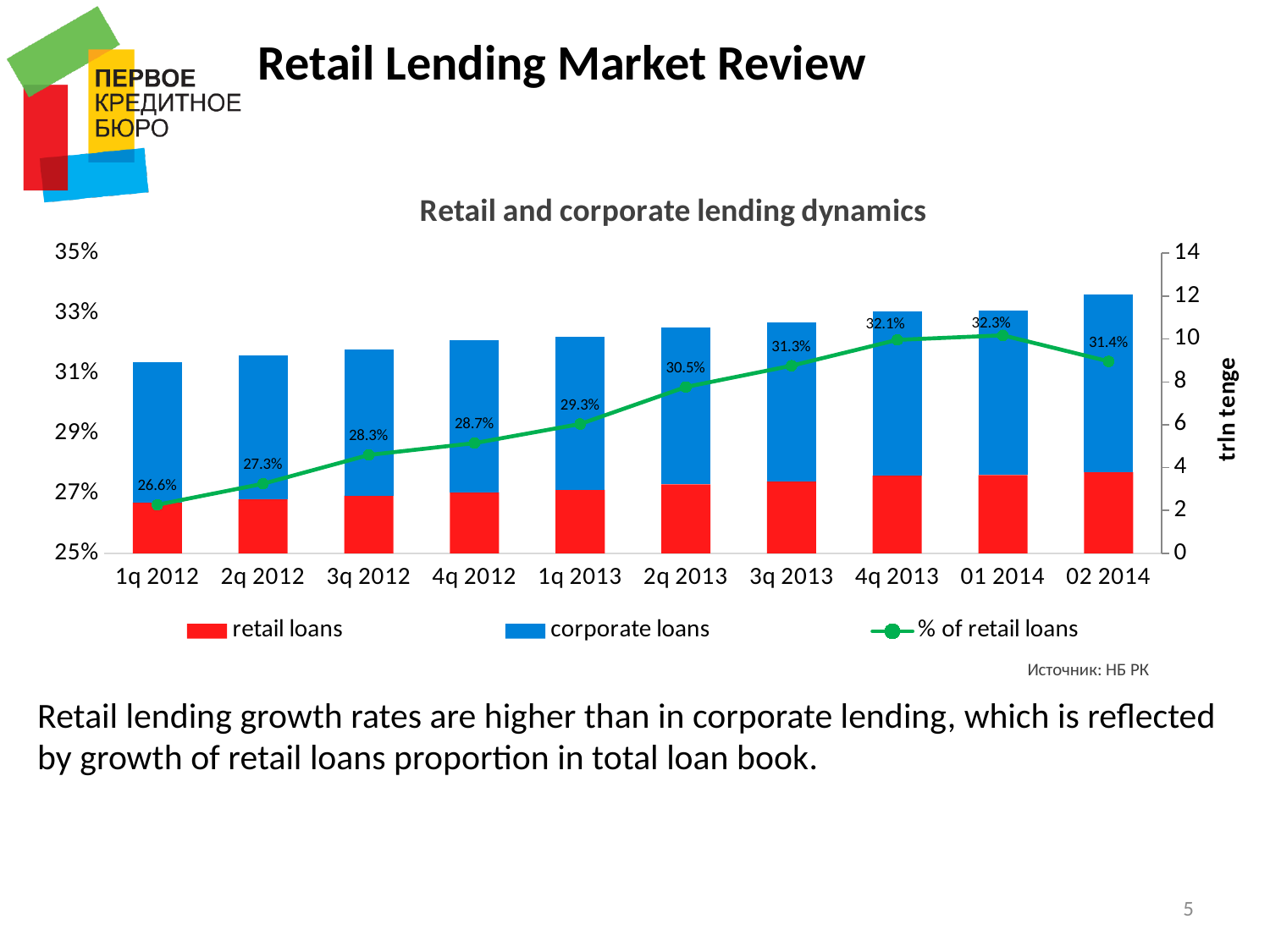
What is the % of retail loans in 4q 2013? 32.1% In which period is the % of retail loans lowest? 1q 2012 What is the % of retail loans in 02 2014? 31.4% By how many percentage points did the % of retail loans increase from 1q 2012 to 01 2014? 5.7 percentage points How many series does the legend list? 3 How many periods are shown on the x axis? 10 What is the % of retail loans in 1q 2012? 26.6% Does the % of retail loans rise or fall from 1q 2012 to 01 2014? Rises In which period is the % of retail loans highest? 01 2014 Is the total of retail and corporate loans in 02 2014 greater or less than 10 trln tenge? greater Which period has a higher % of retail loans, 2q 2013 or 3q 2013? 3q 2013 What kind of chart is shown on the slide? A combination of a stacked bar chart and a line chart